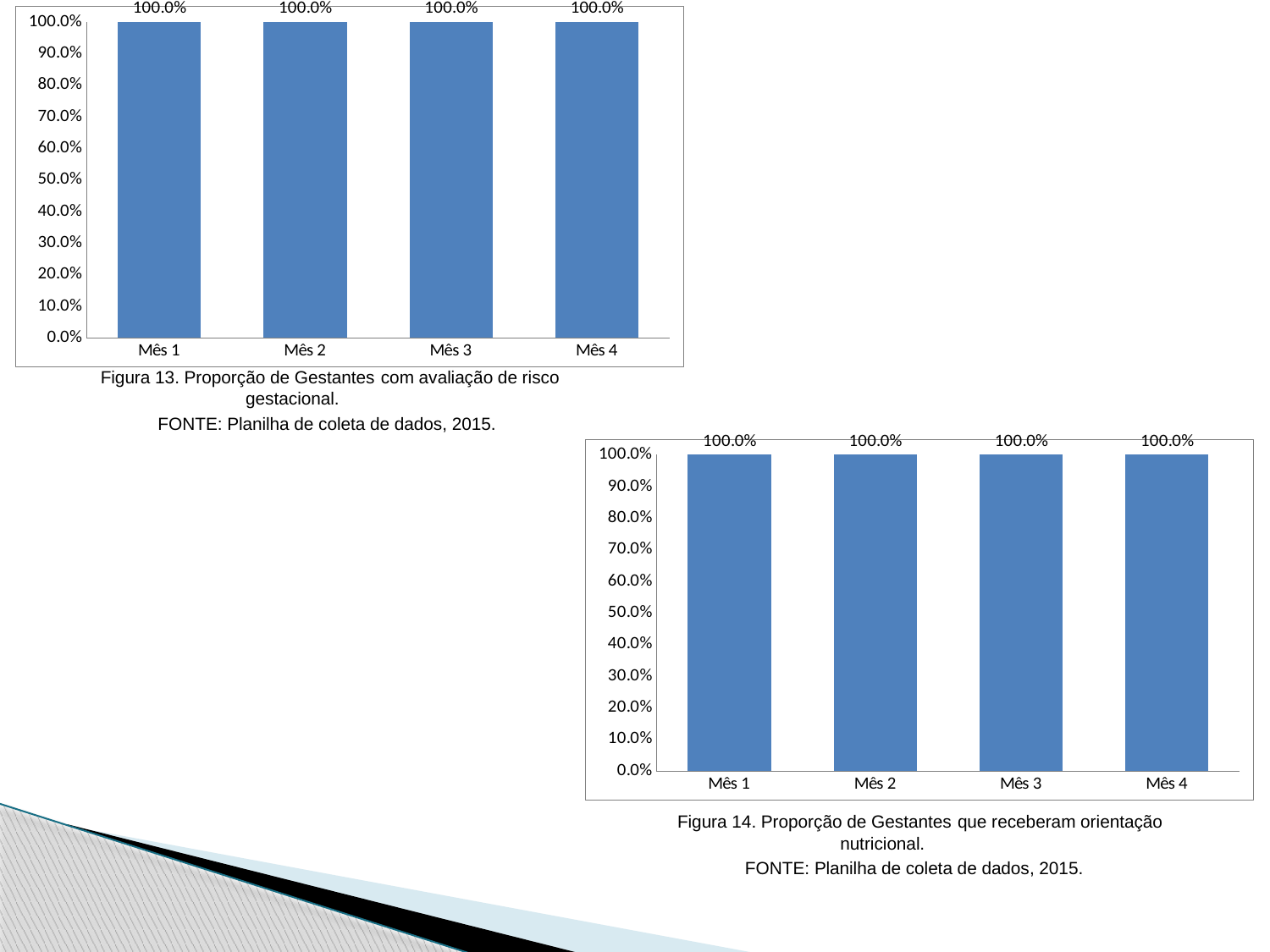
What kind of chart is the top-left chart (Figura 13)? Bar chart In the bottom-right chart (Figura 14), is the value for Mês 4 greater or less than 50.0%? greater In the top-left chart (Figura 13), what is the value for Mês 1? 100.0% In the top-left chart (Figura 13), what is the value for Mês 4? 100.0% In the bottom-right chart (Figura 14), do the values rise, fall or stay the same from Mês 1 to Mês 4? Stay the same In the bottom-right chart (Figura 14), what is the value for Mês 2? 100.0% How many bars does the bottom-right chart (Figura 14) have? 4 How many categories are shown on the x axis of the top-left chart (Figura 13)? 4 In the top-left chart (Figura 13), what is the difference between the values for Mês 1 and Mês 3? 0.0% What is the caption of the top-left chart? Figura 13. Proporção de Gestantes com avaliação de risco gestacional. What source is cited below the bottom-right chart (Figura 14)? FONTE: Planilha de coleta de dados, 2015. In the bottom-right chart (Figura 14), what is the value for Mês 3? 100.0%